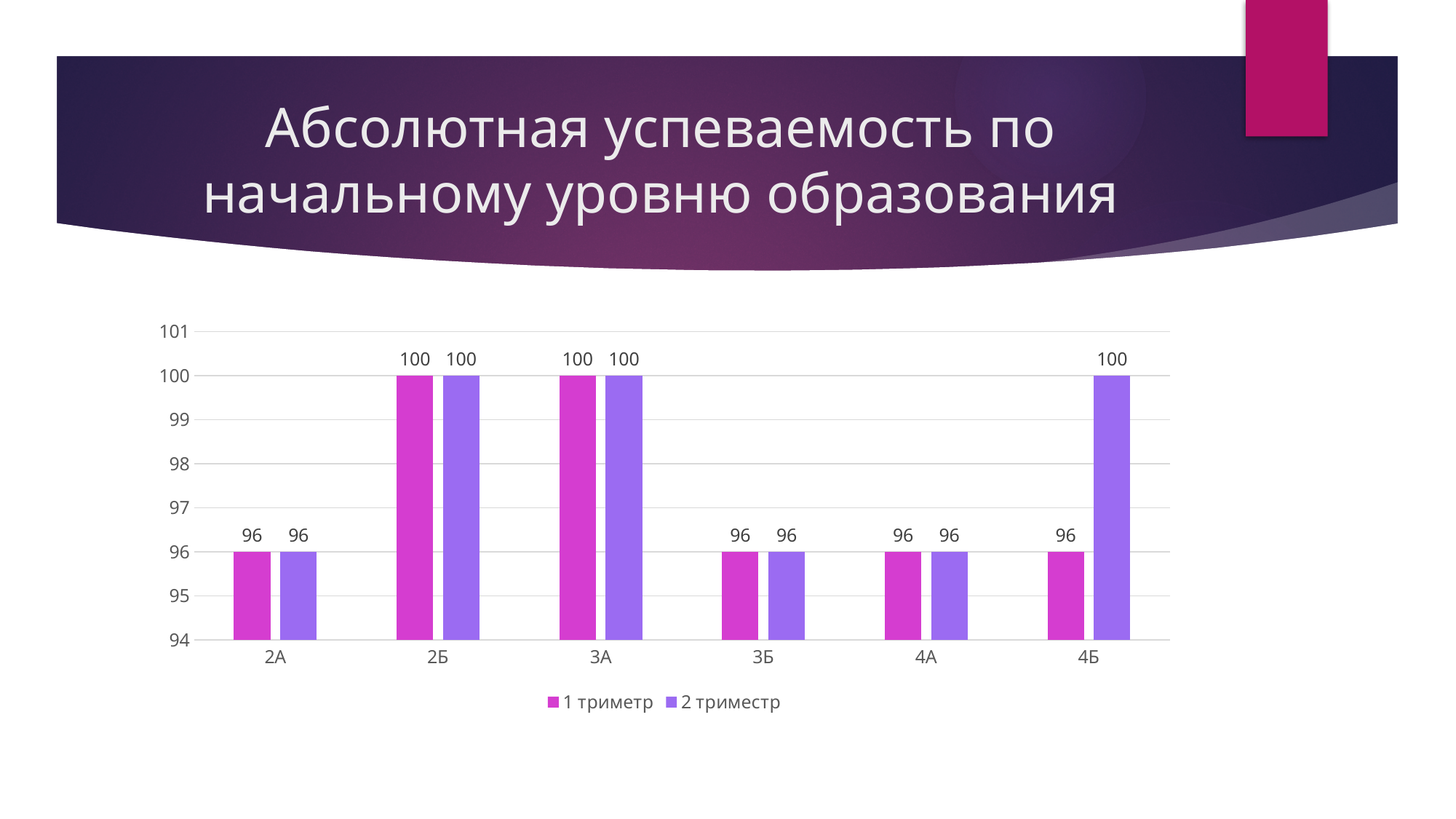
What are the two series listed in the legend? 1 триметр and 2 триместр What is the difference between the 2 триместр and 1 триметр values for 4Б? 4 What is the value for 4Б in the 2 триместр series? 100 What is the value for 2Б in the 1 триметр series? 100 What is the value for 3Б in the 2 триместр series? 96 How many series does the legend list? 2 What is the value for 4Б in the 1 триметр series? 96 Which category has the lowest value in the 2 триместр series? 2А, 3Б and 4А (all 96) For 4Б, which is larger: the 1 триметр value or the 2 триместр value? 2 триместр What is the title of the slide? Абсолютная успеваемость по начальному уровню образования How many categories are shown on the x axis? 6 What kind of chart is shown on the slide? Bar chart